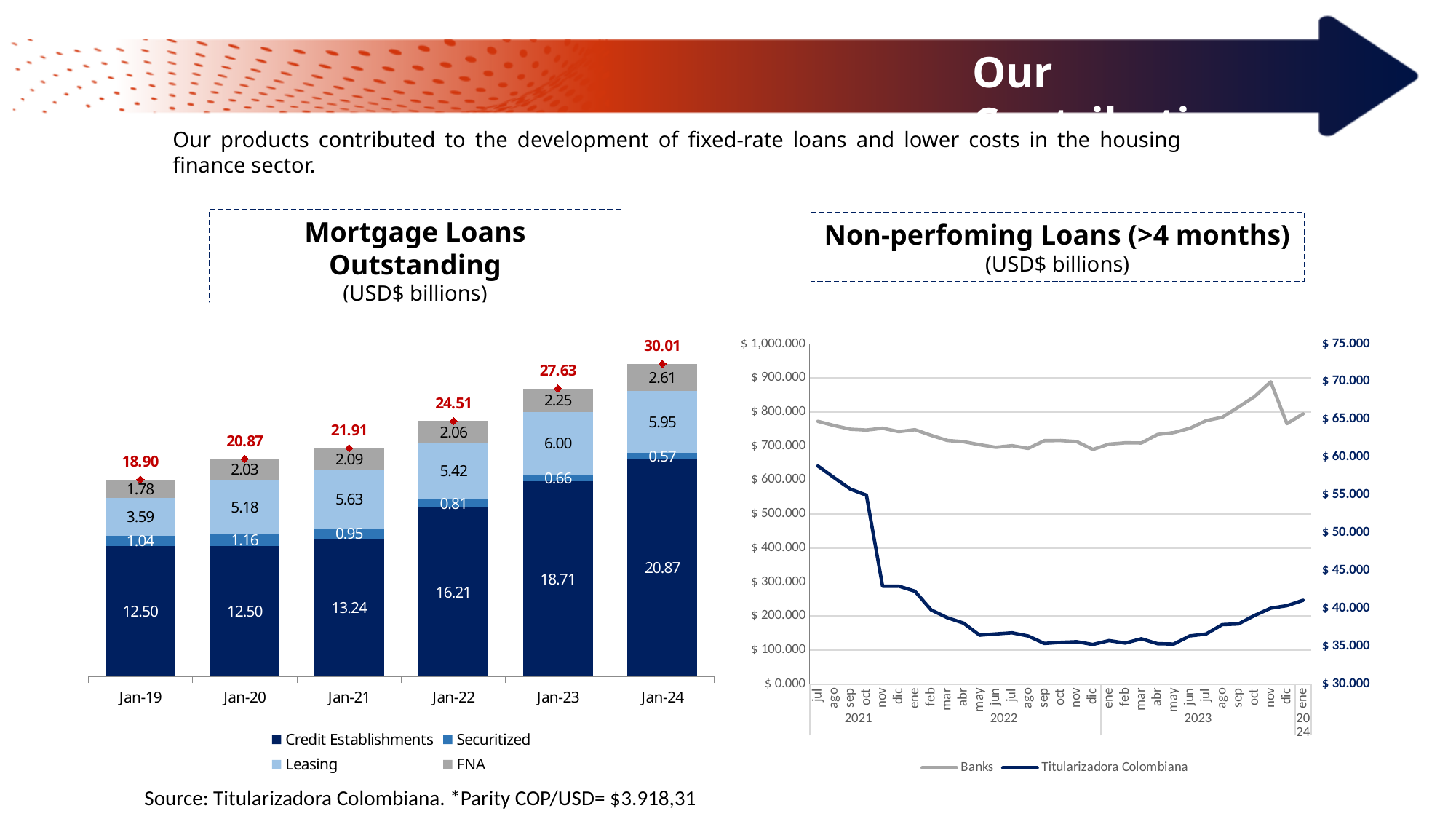
How many series does the legend of the Mortgage Loans Outstanding chart list? 4 In the Mortgage Loans Outstanding chart, what is the total of the stacked bar for Jan-22? 24.51 What kind of chart is the Non-perfoming Loans (>4 months) chart? line chart Do the totals in the Mortgage Loans Outstanding chart rise or fall from Jan-19 to Jan-24? rise In the Mortgage Loans Outstanding chart, which year has the lowest Securitized value? Jan-24 How many years are shown on the x axis of the Mortgage Loans Outstanding chart? 6 In the Mortgage Loans Outstanding chart, what is the difference between the Leasing value in Jan-23 and in Jan-19? 2.41 In the Mortgage Loans Outstanding chart, which year has the highest total? Jan-24 In the Mortgage Loans Outstanding chart, what is the value for Credit Establishments in Jan-24? 20.87 In the Non-perfoming Loans (>4 months) chart, is the Titularizadora Colombiana value in jul 2021 greater or less than $500.000? less In the Mortgage Loans Outstanding chart, what is the FNA value for Jan-19? 1.78 In the Mortgage Loans Outstanding chart, is the Leasing value larger in Jan-23 or Jan-24? Jan-23